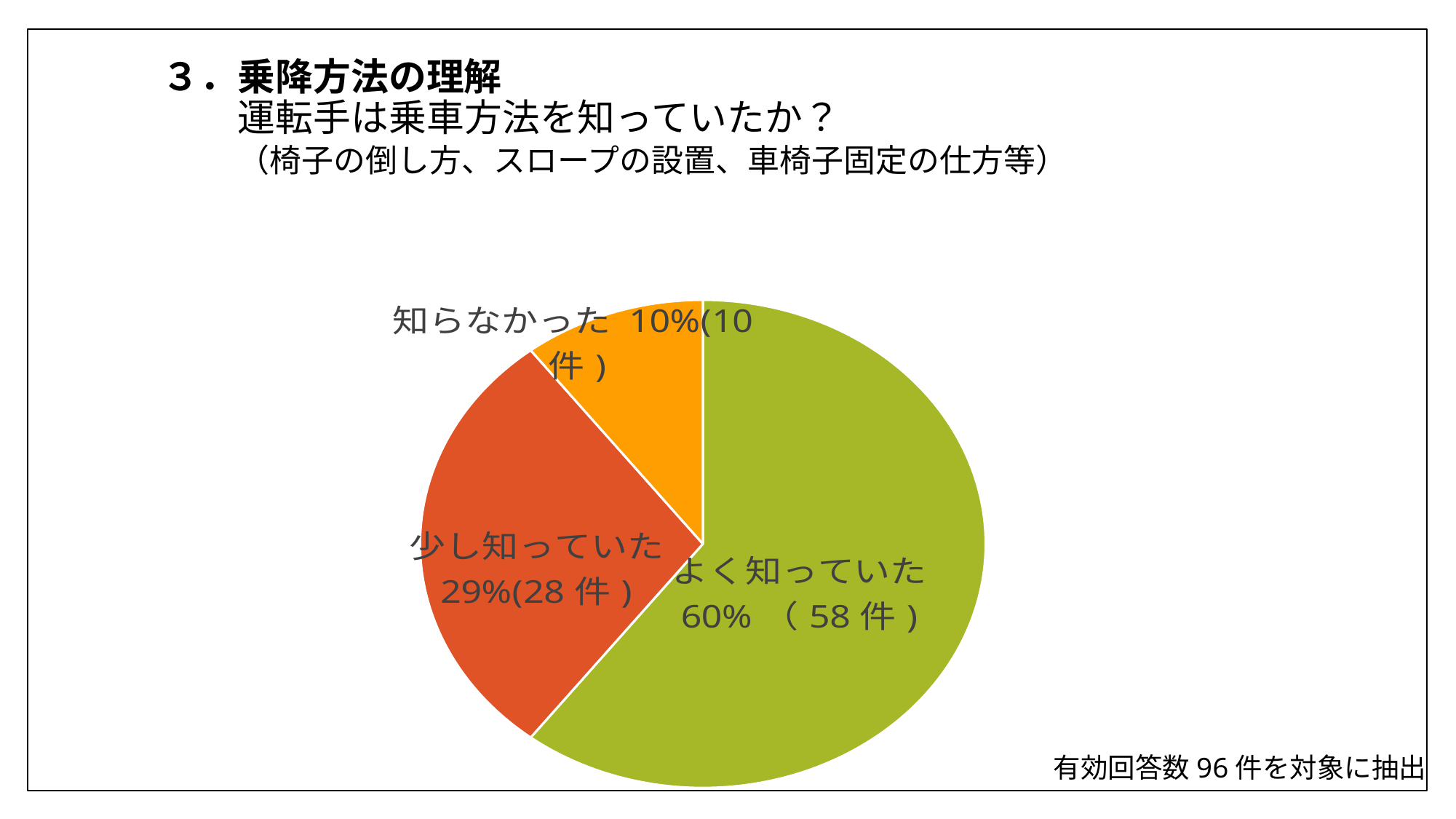
Which slice is the largest? よく知っていた What percentage share does the 少し知っていた slice have? 29% What kind of chart is shown on the slide? pie chart Which slice is the smallest? 知らなかった How many slices does the pie chart have? 3 What percentage share does the よく知っていた slice have? 60% Which colour is the よく知っていた slice? green How many responses (件) are in the 少し知っていた slice? 28 件 How many responses (件) are in the 知らなかった slice? 10 件 How many responses (件) are in the よく知っていた slice? 58 件 What percentage share does the 知らなかった slice have? 10% What is the difference in responses between よく知っていた and 少し知っていた? 30 件